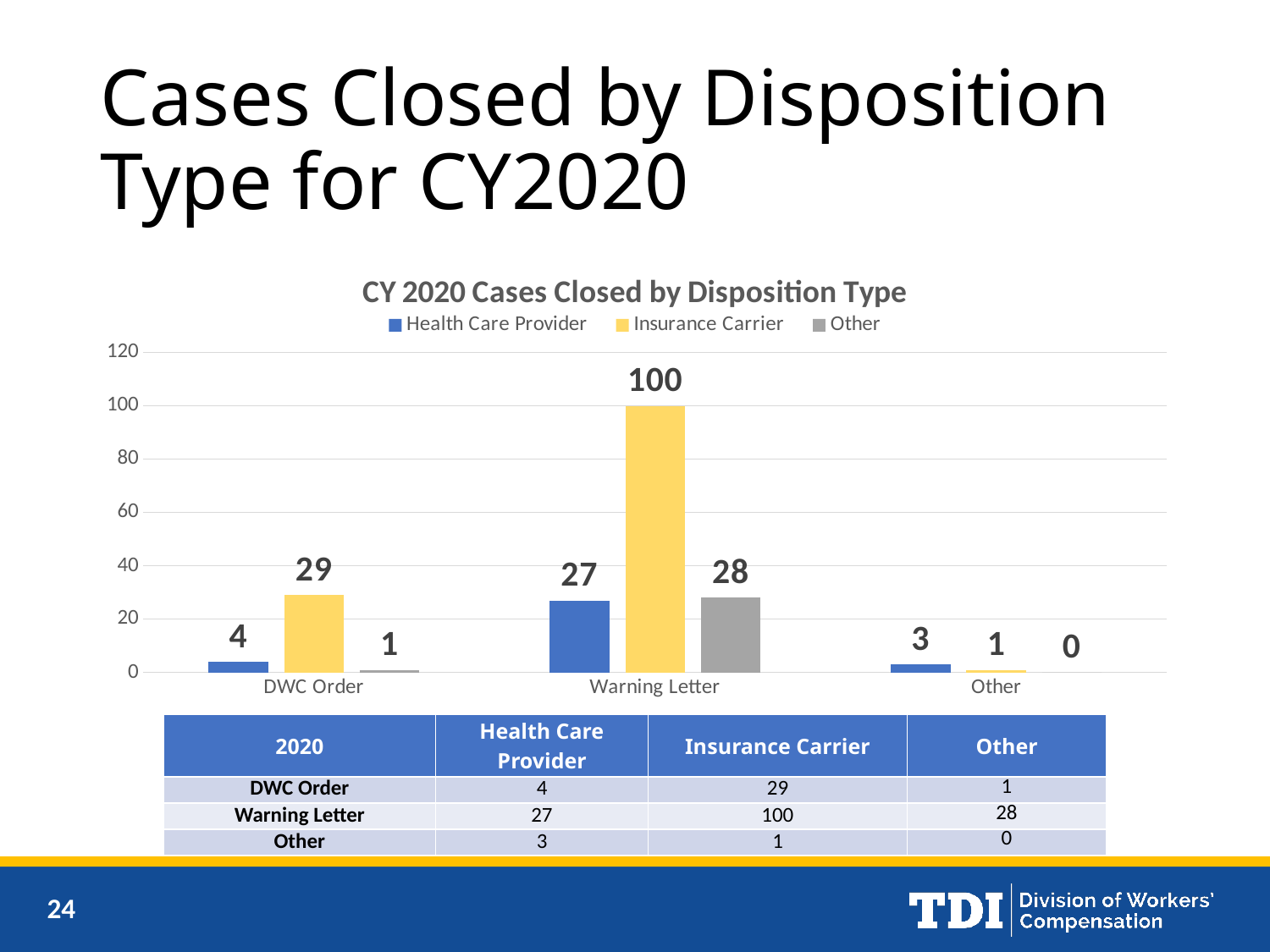
How many categories are shown on the x axis? 3 Which category has the lowest Other value? Other What is the value for Other in the Warning Letter category? 28 What is the title of the chart? CY 2020 Cases Closed by Disposition Type What is the value for Health Care Provider in the DWC Order category? 4 What is the difference between the Insurance Carrier and Health Care Provider values in the Warning Letter category? 73 Which category has the highest Insurance Carrier value? Warning Letter Is the Insurance Carrier value for Warning Letter greater or less than 80? greater How many series does the legend list? 3 What is the value for Insurance Carrier in the Warning Letter category? 100 Which is larger in the DWC Order category: Health Care Provider or Insurance Carrier? Insurance Carrier What kind of chart is shown? Bar chart